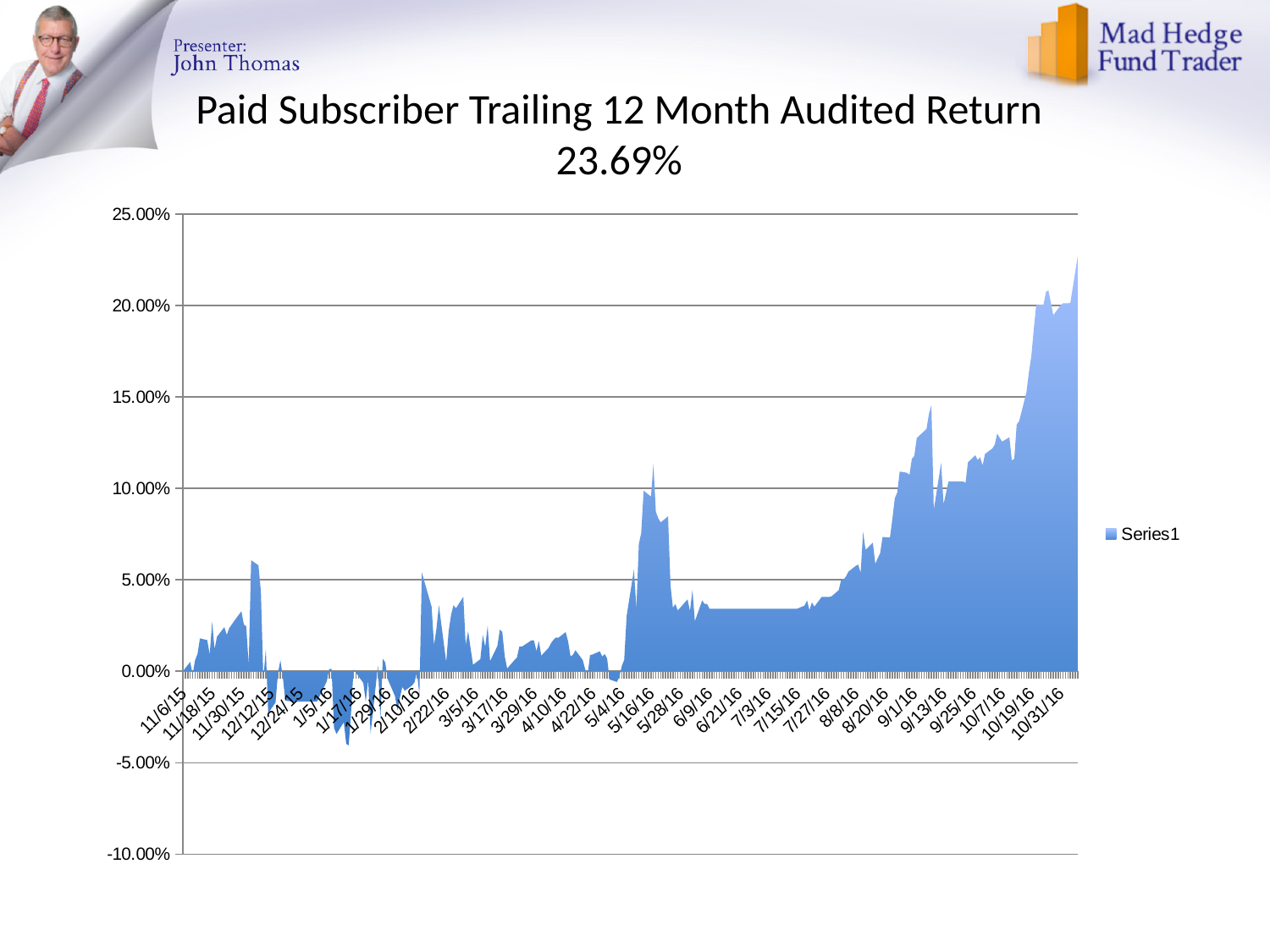
Is the value for 8/8/16 greater or less than 10.00%? less What is the name of the series shown in the legend? Series1 Is the value for 10/19/16 greater or less than 15.00%? greater Is the value for 5/16/16 greater or less than 5.00%? greater Overall, do the values rise or fall from 11/6/15 to 10/31/16? Rise How many series does the legend list? 1 Which is larger, the value for 10/31/16 or the value for 3/5/16? 10/31/16 What kind of chart is shown on the slide? Area chart What is the title of the chart on the slide? Paid Subscriber Trailing 12 Month Audited Return 23.69%